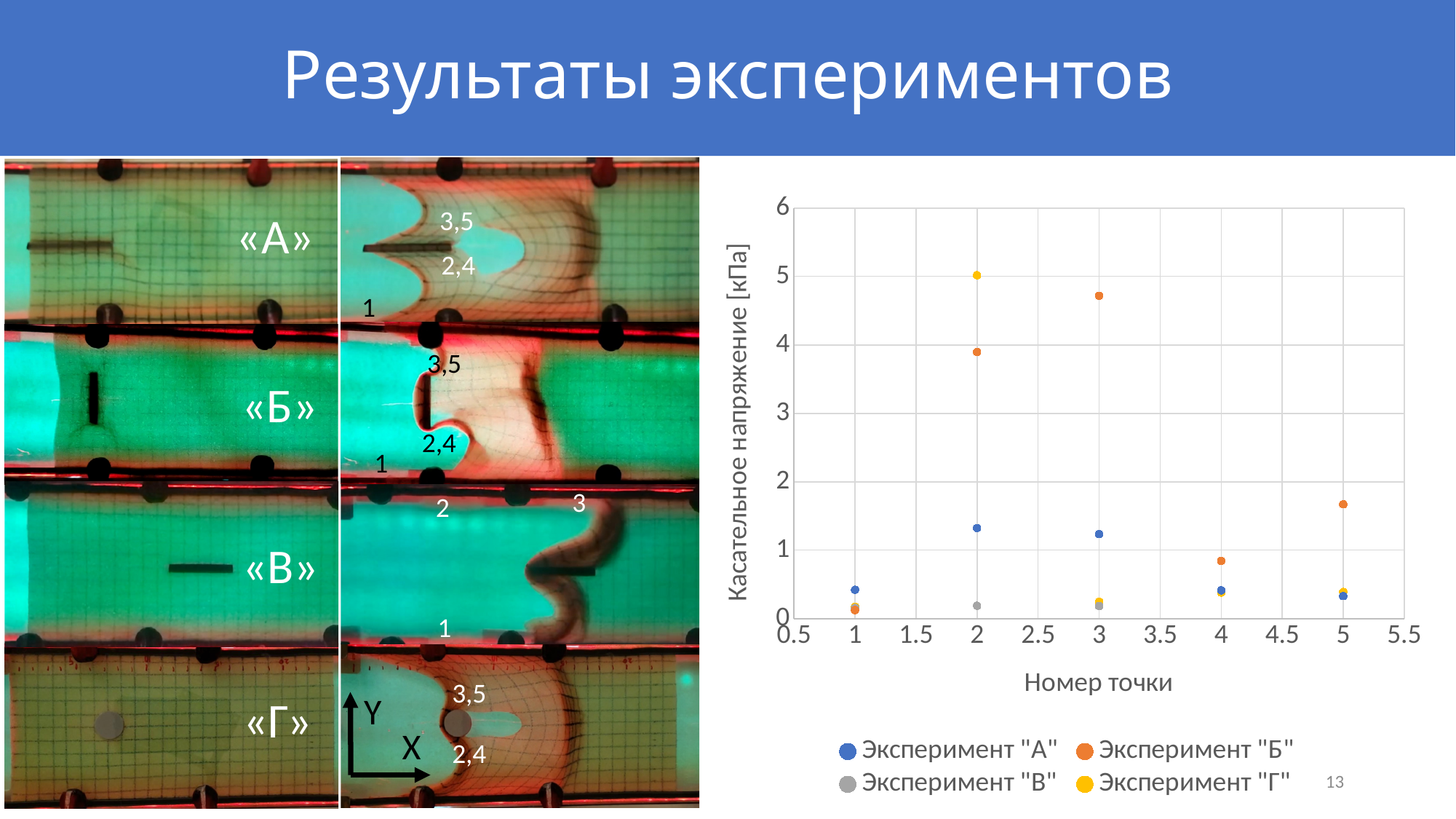
Is the value for Эксперимент "А" at point 2 greater or less than 2? less Is the value for Эксперимент "Б" at point 2 greater or less than 3? greater At point 2, which series has the higher value: Эксперимент "Г" or Эксперимент "Б"? Эксперимент "Г" Which series has the highest value at point 3? Эксперимент "Б" Is the value for Эксперимент "Б" at point 5 greater or less than 1? greater What is the title of the horizontal axis of the chart? Номер точки How many series does the legend of the chart list? 4 What kind of chart is shown on the right side of the slide? scatter chart What is the title of the vertical axis of the chart? Касательное напряжение [кПа] At point 3, which series has the higher value: Эксперимент "Б" or Эксперимент "А"? Эксперимент "Б"